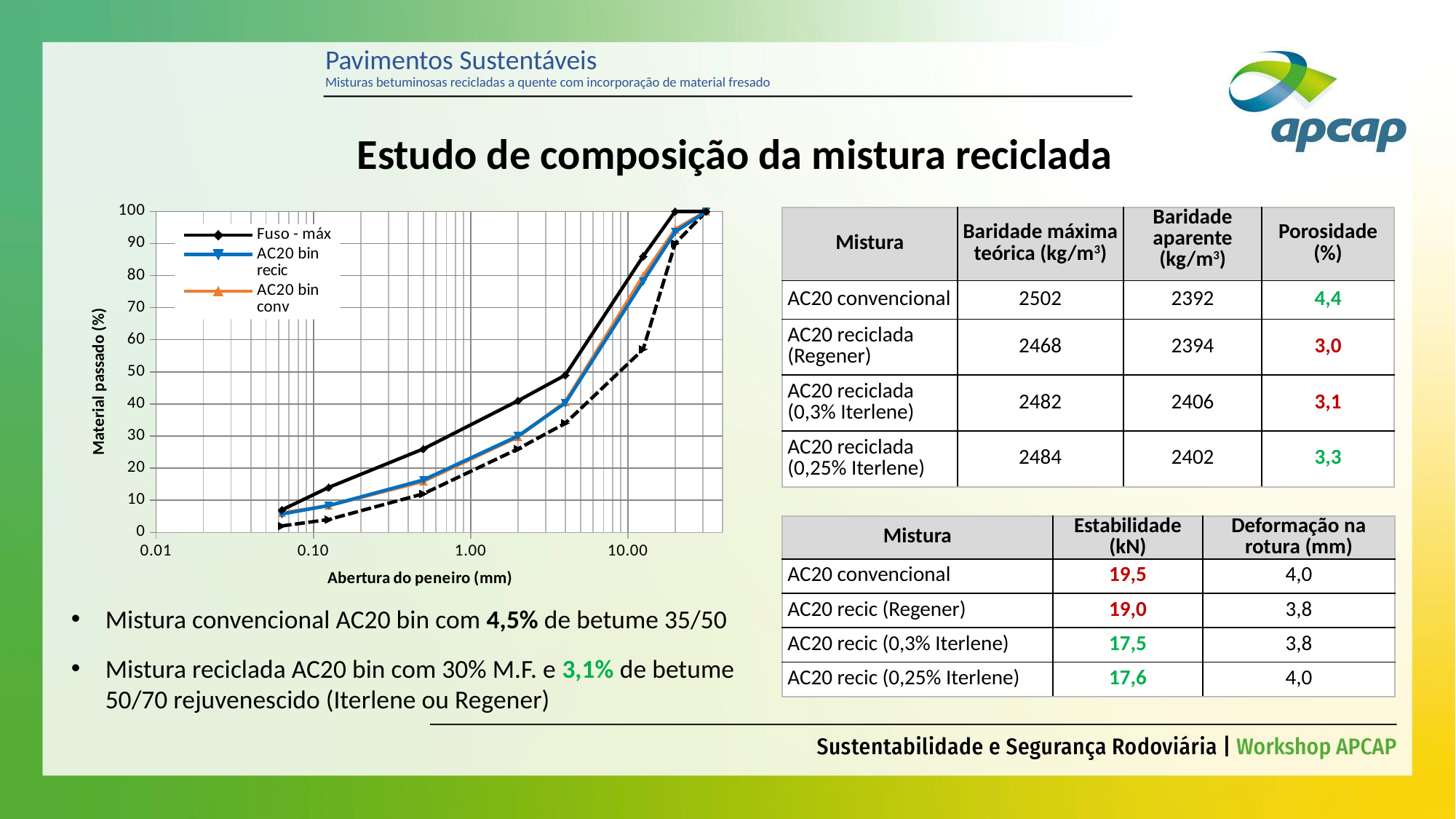
Do the values of the Fuso - máx series rise or fall as the sieve opening increases along the x axis? Rise How many series does the chart legend list? 3 At the smallest sieve opening plotted, is the value for Fuso - máx greater or less than 10? less What colour is the line for the AC20 bin conv series? Orange What kind of chart is shown on the slide? Line chart Which series lies highest on the chart across the sieve openings, Fuso - máx or AC20 bin recic? Fuso - máx At the largest sieve opening plotted, is the value for AC20 bin recic greater or less than 90? greater Which series is drawn in blue, AC20 bin recic or Fuso - máx? AC20 bin recic What is the title of the chart's x axis? Abertura do peneiro (mm) At the smallest sieve opening plotted, is the value for AC20 bin recic greater or less than 10? less